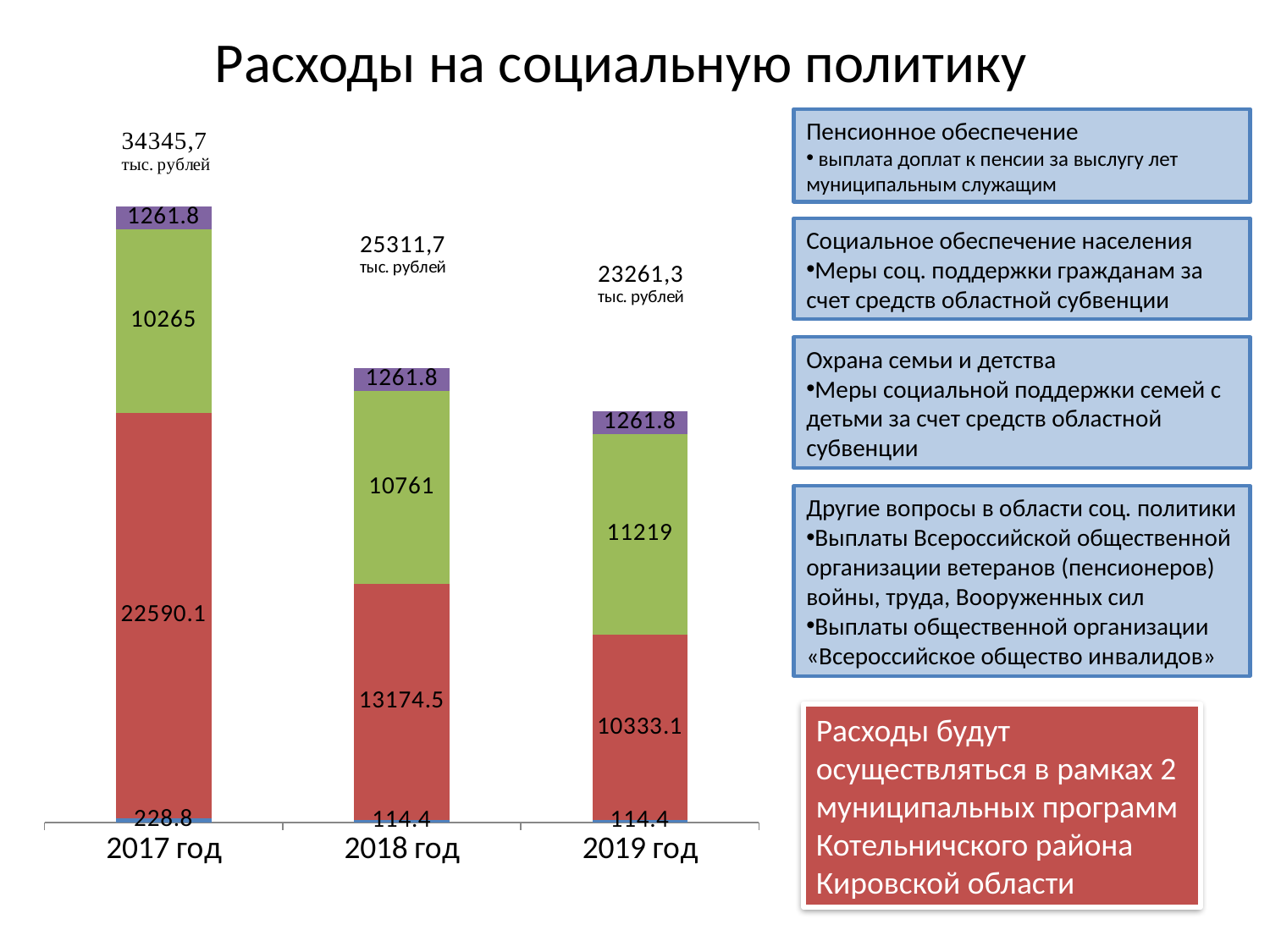
How many years (categories) are shown on the x axis of the chart? 3 Which year has the highest total expenditure? 2017 год Which is larger, the green segment for 2018 год or for 2019 год? 2019 год What is the total printed above the bar for 2018 год? 25311,7 тыс. рублей Does the red segment rise or fall from 2017 год to 2019 год? fall Which year has the lowest total expenditure? 2019 год What is the value of the blue segment at the bottom of the 2017 год bar? 228.8 What is the value of the red segment for 2017 год? 22590.1 What is the value of the green segment for 2019 год? 11219 What is the value of the purple segment for 2019 год? 1261.8 What is the difference between the red segment values for 2017 год and 2018 год? 9415.6 What kind of chart is shown on the slide? stacked bar chart